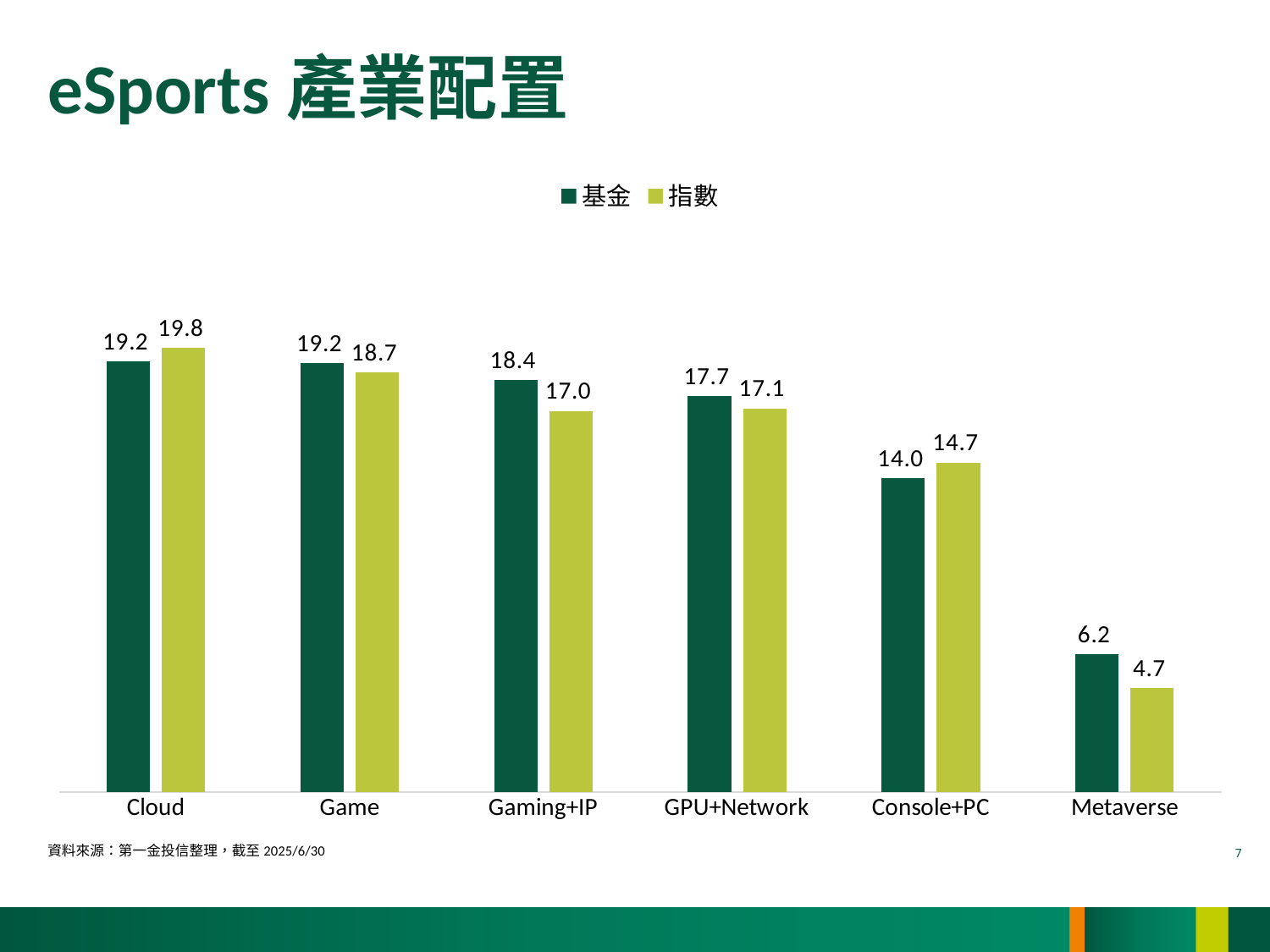
What is the 基金 value for Cloud? 19.2 How many series does the legend list? 2 Which category has the lowest 基金 value? Metaverse What is the difference between the 基金 and 指數 values for Gaming+IP? 1.4 Do the 基金 values rise or fall from Cloud to Metaverse along the x axis? Fall For Game, which is larger, the 基金 value or the 指數 value? 基金 How many categories are shown on the x axis? 6 What are the two series named in the legend? 基金 and 指數 What kind of chart is shown on the slide? Bar chart What is the 指數 value for Metaverse? 4.7 What is the 指數 value for Console+PC? 14.7 Which category has the highest 指數 value? Cloud